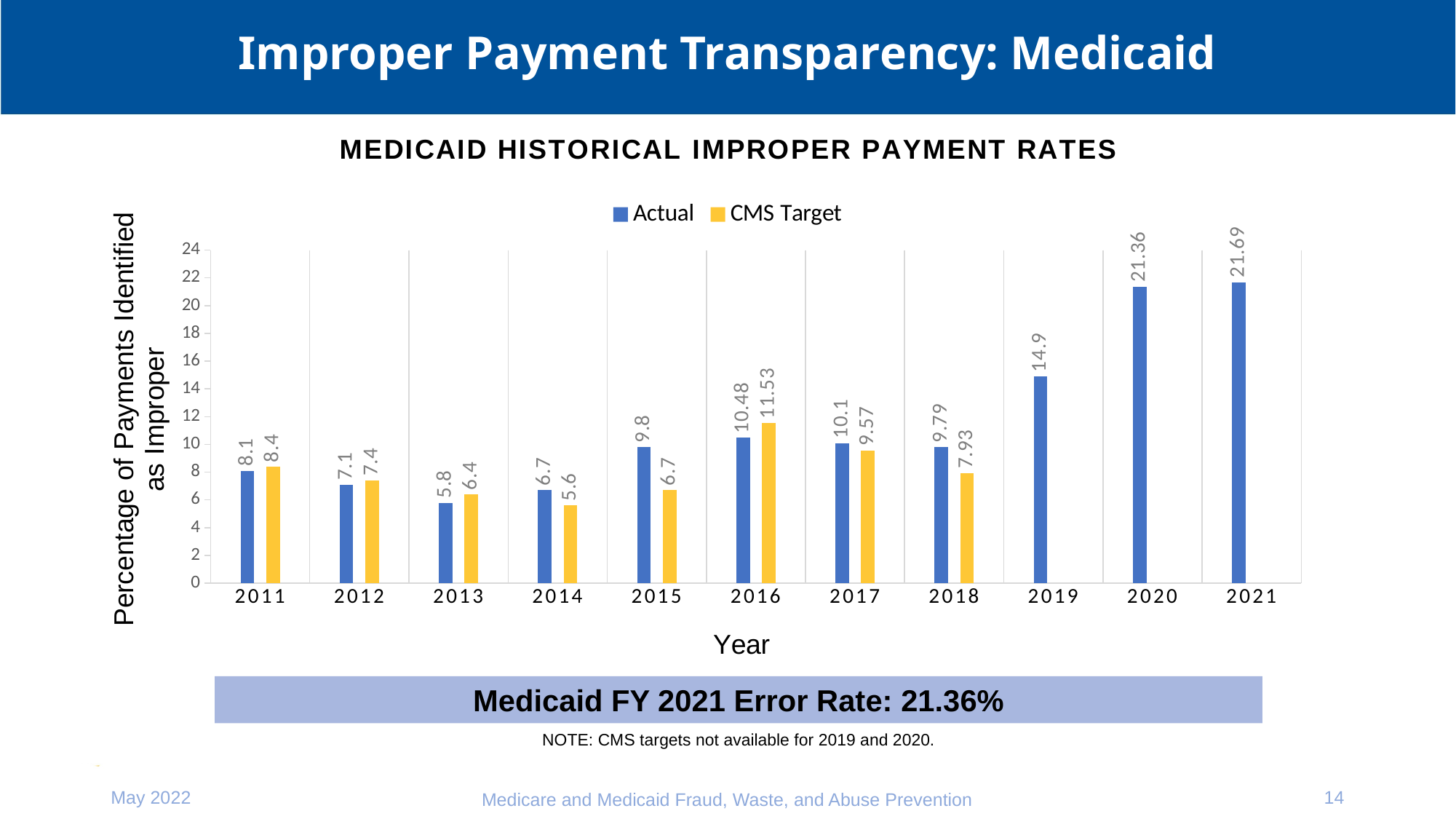
In 2017, which is larger: the Actual value or the CMS Target value? Actual How many years are shown on the x axis? 11 What is the difference between the Actual value and the CMS Target value in 2015? 3.1 What kind of chart is shown on the slide? Bar chart Which year has the lowest Actual improper payment rate? 2013 What is the title of the chart? Medicaid Historical Improper Payment Rates Is the Actual value for 2019 greater or less than 14? greater How many series does the legend list? 2 Which year has the highest Actual improper payment rate? 2021 Does the Actual improper payment rate rise or fall from 2018 to 2021? Rise What is the CMS Target value for 2018? 7.93 What is the Actual improper payment rate for 2016? 10.48